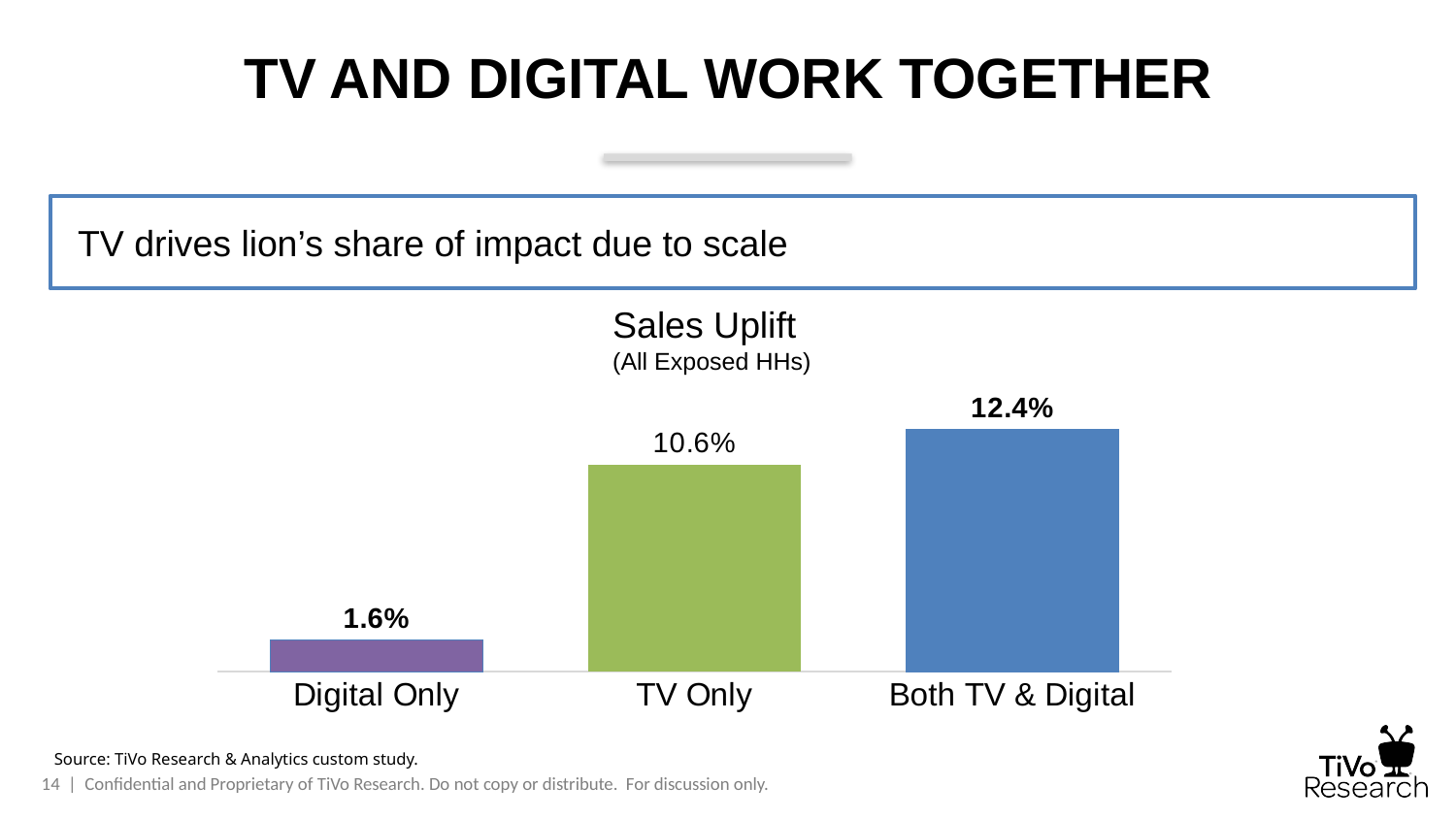
What is the sales uplift for TV Only? 10.6% What is the difference in sales uplift between Both TV & Digital and TV Only? 1.8% What colour is the bar for TV Only? Green What is the title of the chart? Sales Uplift (All Exposed HHs) Which category has the highest sales uplift? Both TV & Digital What is the difference in sales uplift between TV Only and Digital Only? 9.0% What type of chart is shown on the slide? Bar chart Which category has the lowest sales uplift? Digital Only How many categories are shown in the chart? 3 What is the sales uplift for Digital Only? 1.6% What is the sales uplift for Both TV & Digital? 12.4% Which has a larger sales uplift, TV Only or Digital Only? TV Only